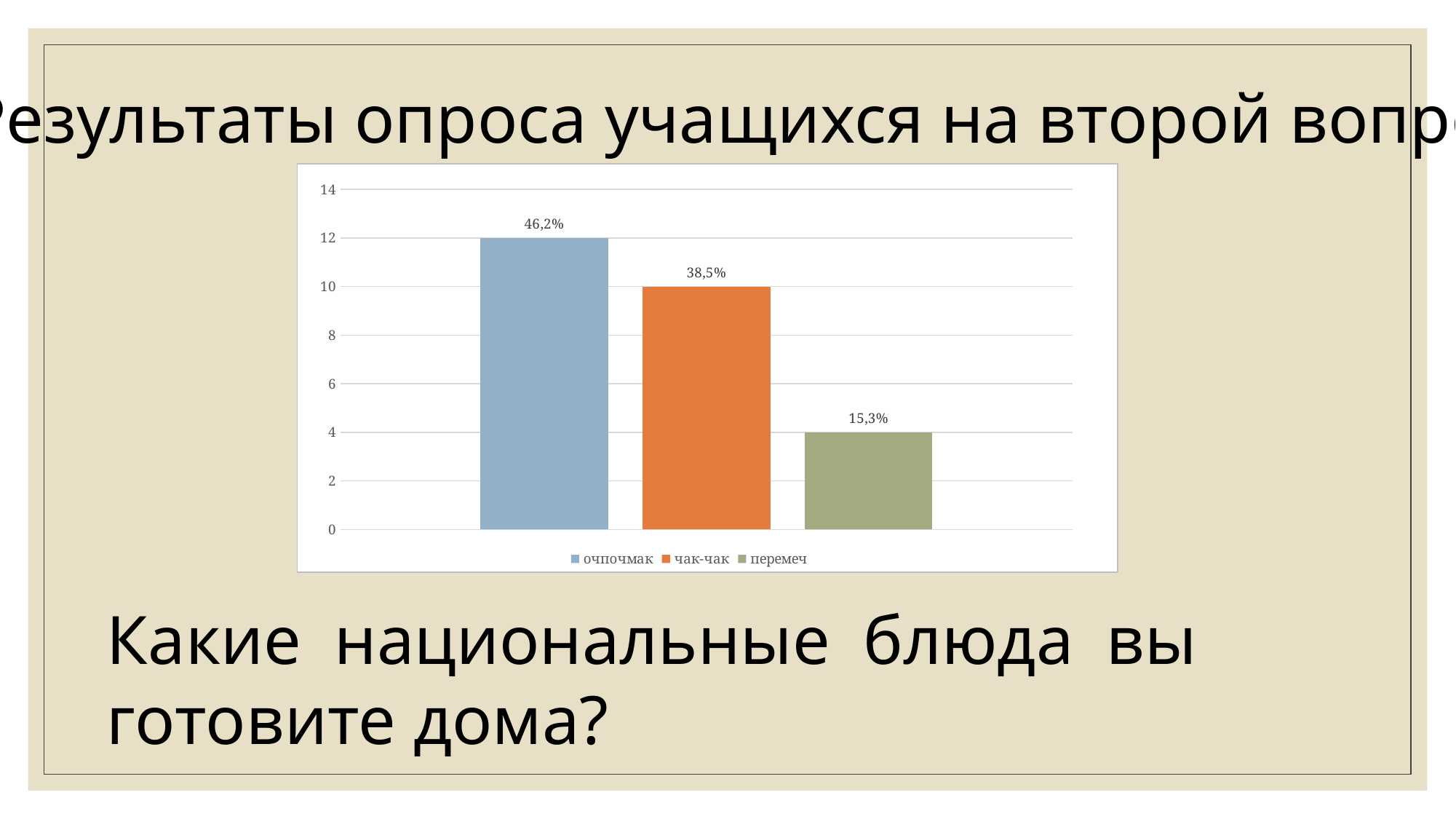
Is the bar for перемеч greater or less than 6 on the vertical axis? less What kind of chart is shown on the slide? bar chart What data label is shown above the bar for очпочмак? 46,2% What data label is shown above the bar for чак-чак? 38,5% Which category has the highest bar? очпочмак Which is larger, the bar for чак-чак or the bar for перемеч? чак-чак How many entries does the legend list? 3 What data label is shown above the bar for перемеч? 15,3% Is the bar for очпочмак greater or less than 10 on the vertical axis? greater How many bars are plotted in the chart? 3 What is the difference between the percentage labels for очпочмак and чак-чак? 7,7% Which category has the lowest bar? перемеч